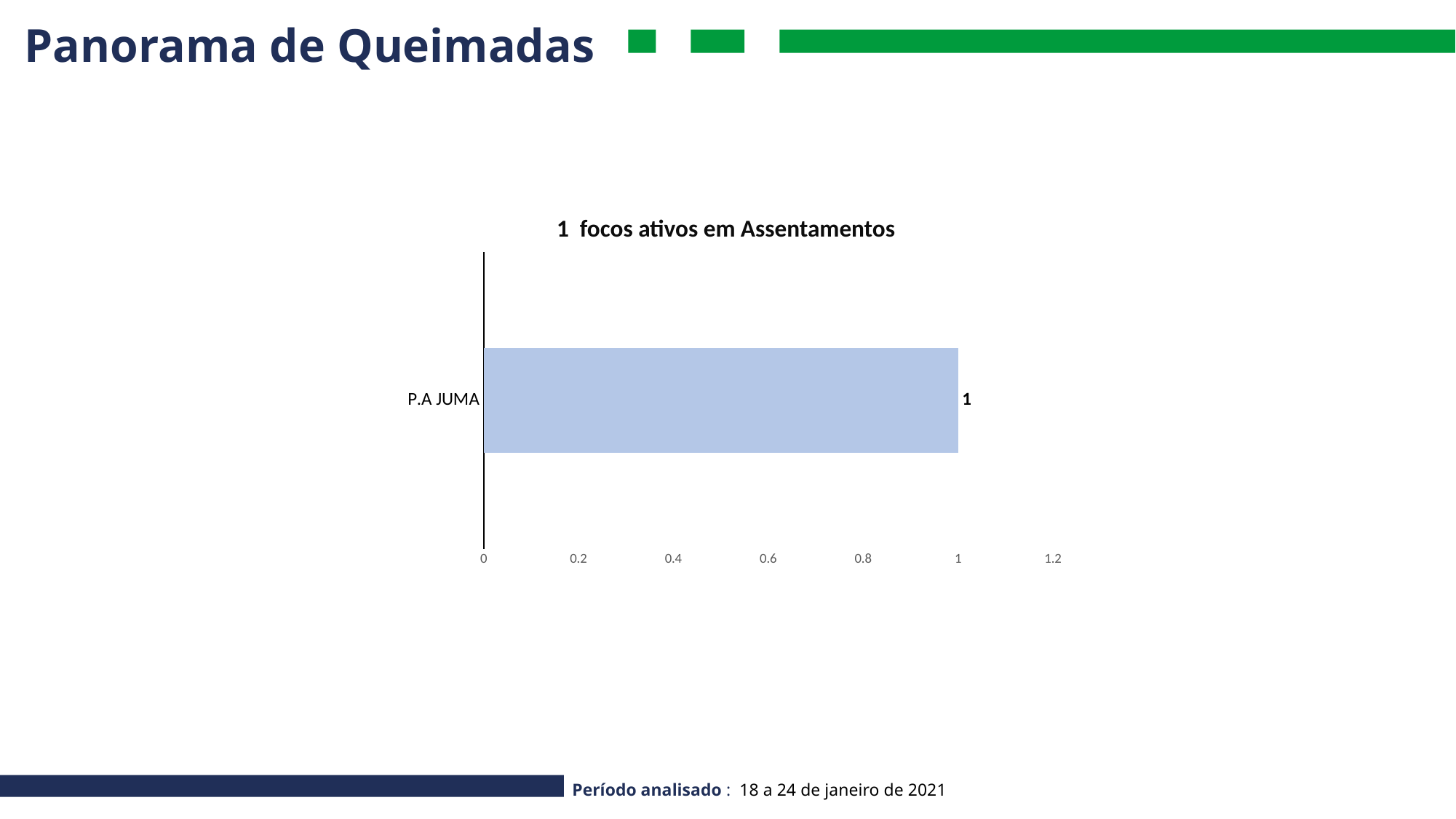
Is the value for P.A JUMA greater or less than 1.2? less How many categories are plotted in the chart? 1 Which category has the highest value in the chart? P.A JUMA What is the value for P.A JUMA? 1 Is the value for P.A JUMA greater or less than 0.8? greater What is the title of the chart? 1 focos ativos em Assentamentos What kind of chart is shown on the slide? bar chart What is the highest value shown on the x axis? 1.2